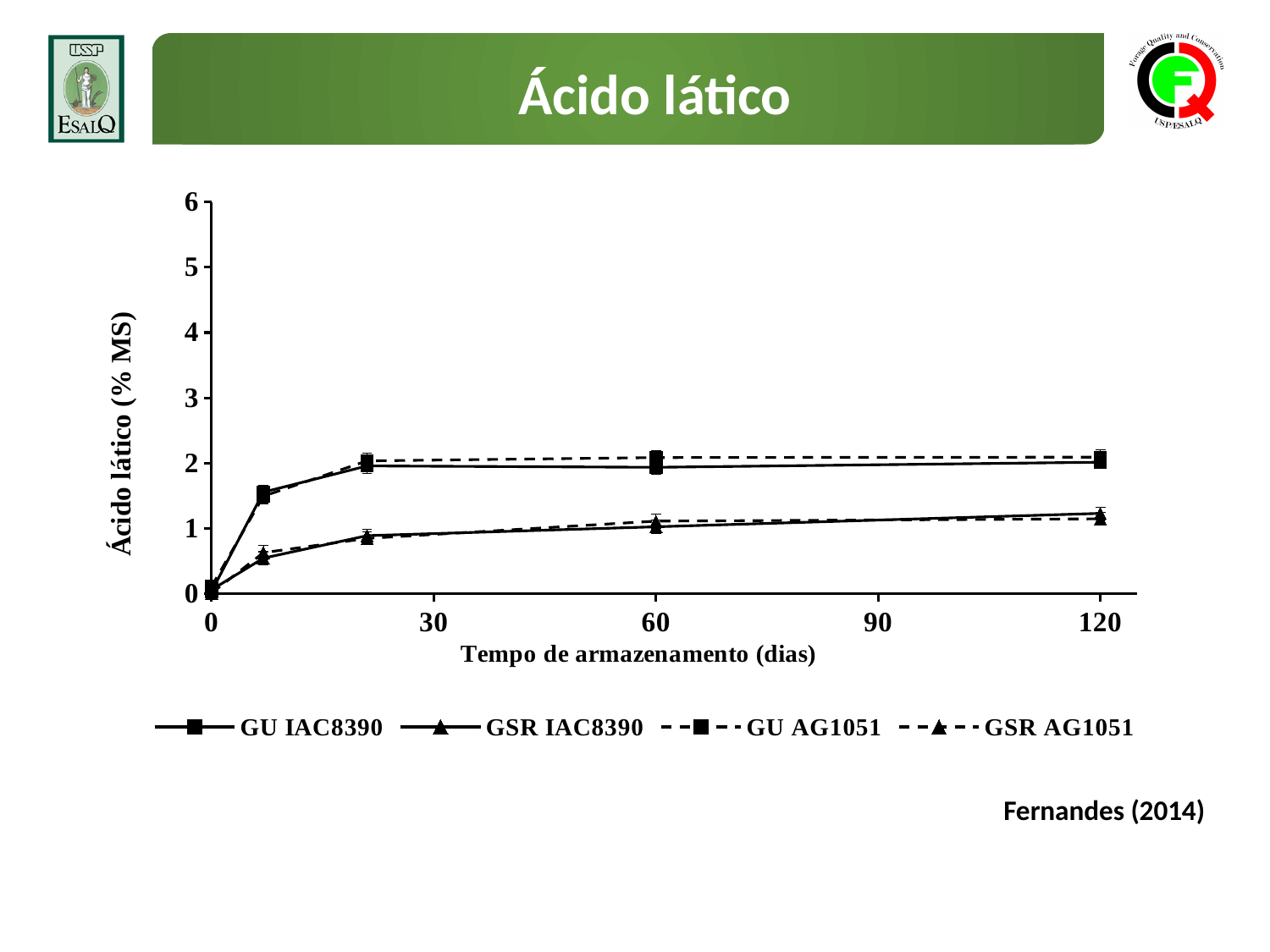
At 120 days, which is larger, GU IAC8390 or GSR IAC8390? GU IAC8390 Do the values for GU IAC8390 rise or fall from 0 to 120 days? rise Is the value for GU IAC8390 at 120 days greater or less than 1? greater What is the title of the chart? Ácido lático Is the value for GSR AG1051 at 60 days greater or less than 2? less What kind of chart is shown on the slide? line chart At 60 days, which is larger, GSR AG1051 or GU AG1051? GU AG1051 Is the value for GU AG1051 at 60 days greater or less than 3? less How many data points are plotted for each series? 5 What is the label of the x axis? Tempo de armazenamento (dias) How many series does the legend list? 4